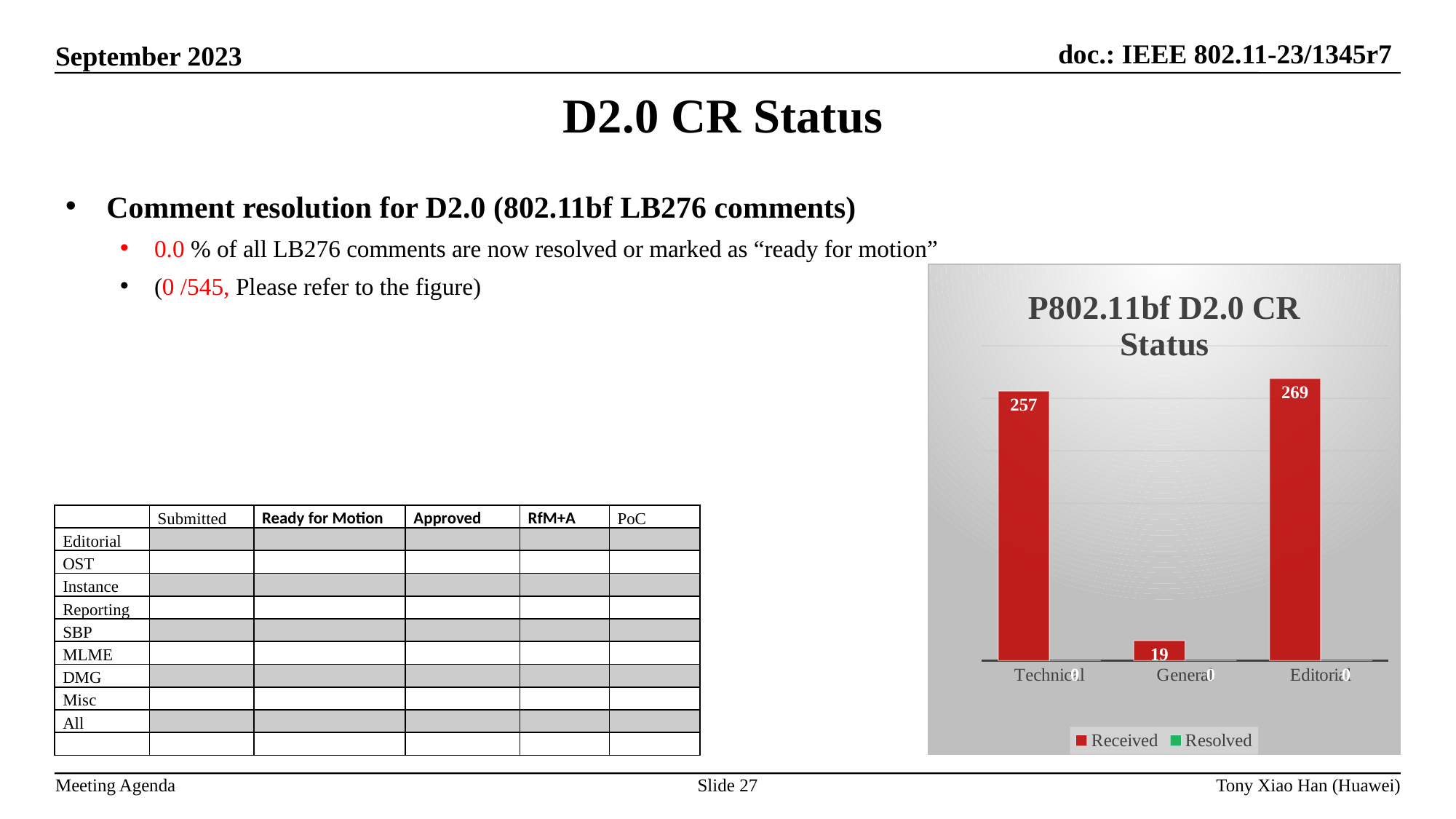
Which category has the highest Received value? Editorial What is the title of the chart? P802.11bf D2.0 CR Status What is the difference between the Received values for Editorial and Technical? 12 What is the Received value for General? 19 Which category has the lowest Received value? General Which is larger, the Received value for Technical or for General? Technical What type of chart is shown on the slide? bar chart How many series does the chart legend list? 2 What is the Received value for Technical? 257 How many categories are shown on the x axis of the chart? 3 What is the Received value for Editorial? 269 What are the two series named in the chart legend? Received and Resolved